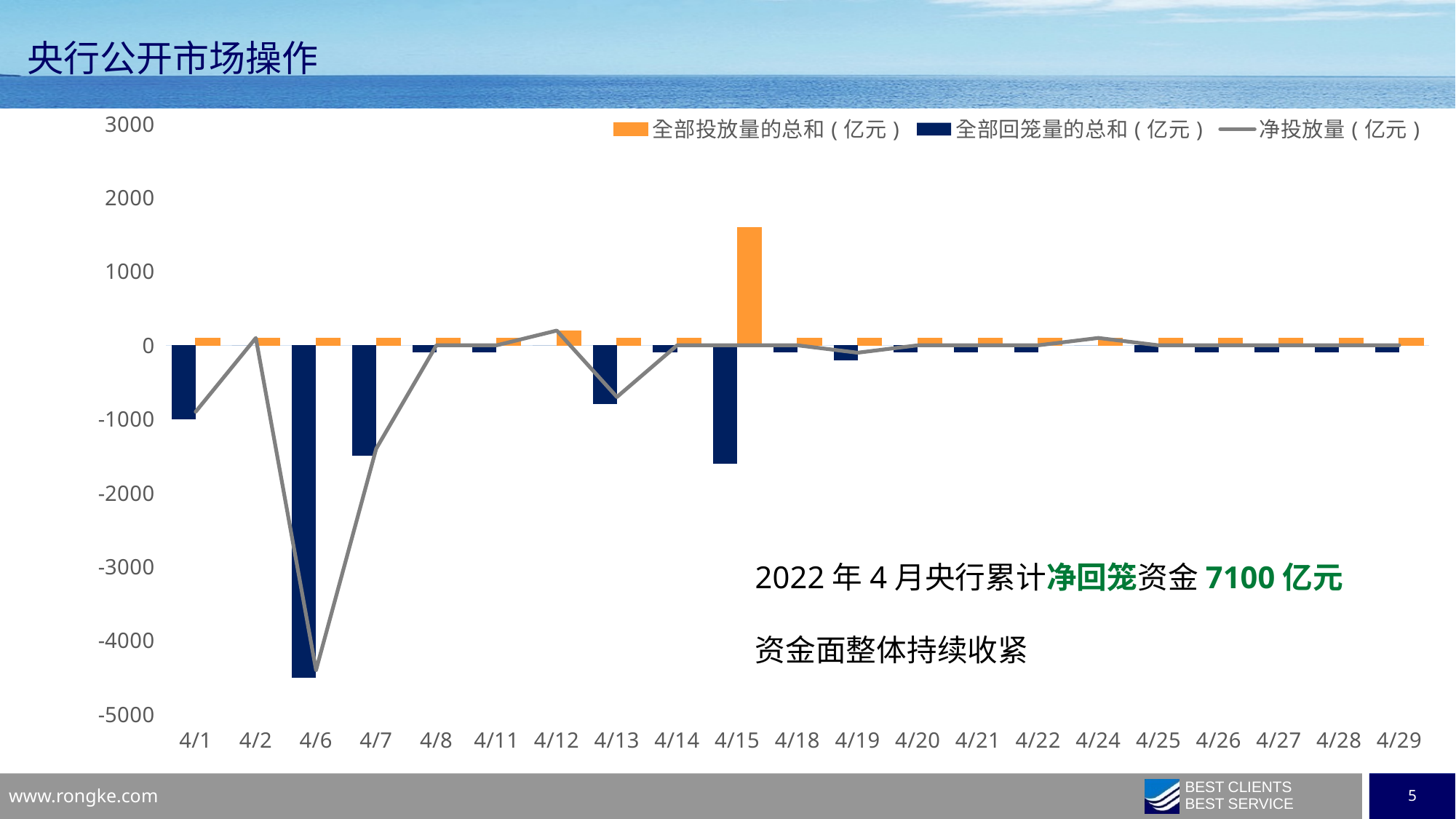
On which date does the 全部回笼量的总和 bar reach its lowest (most negative) value? 4/6 What is the title of the chart on the slide? 央行公开市场操作 How many series does the chart legend list? 3 How many dates are shown on the x axis of the chart? 21 Which series is drawn as a grey line in the chart? 净投放量（亿元） What kind of chart is shown on the slide? Combined bar and line chart Is the 全部回笼量的总和 value for 4/7 greater or less than -1000? less On which date does the 净投放量 line reach its lowest point? 4/6 Is the 全部投放量的总和 value for 4/15 greater or less than 1000? greater Is the 全部回笼量的总和 value for 4/6 greater or less than -4000? less Which date has the larger (more negative) 全部回笼量的总和 bar, 4/6 or 4/7? 4/6 On which date does the 全部投放量的总和 bar reach its highest value? 4/15